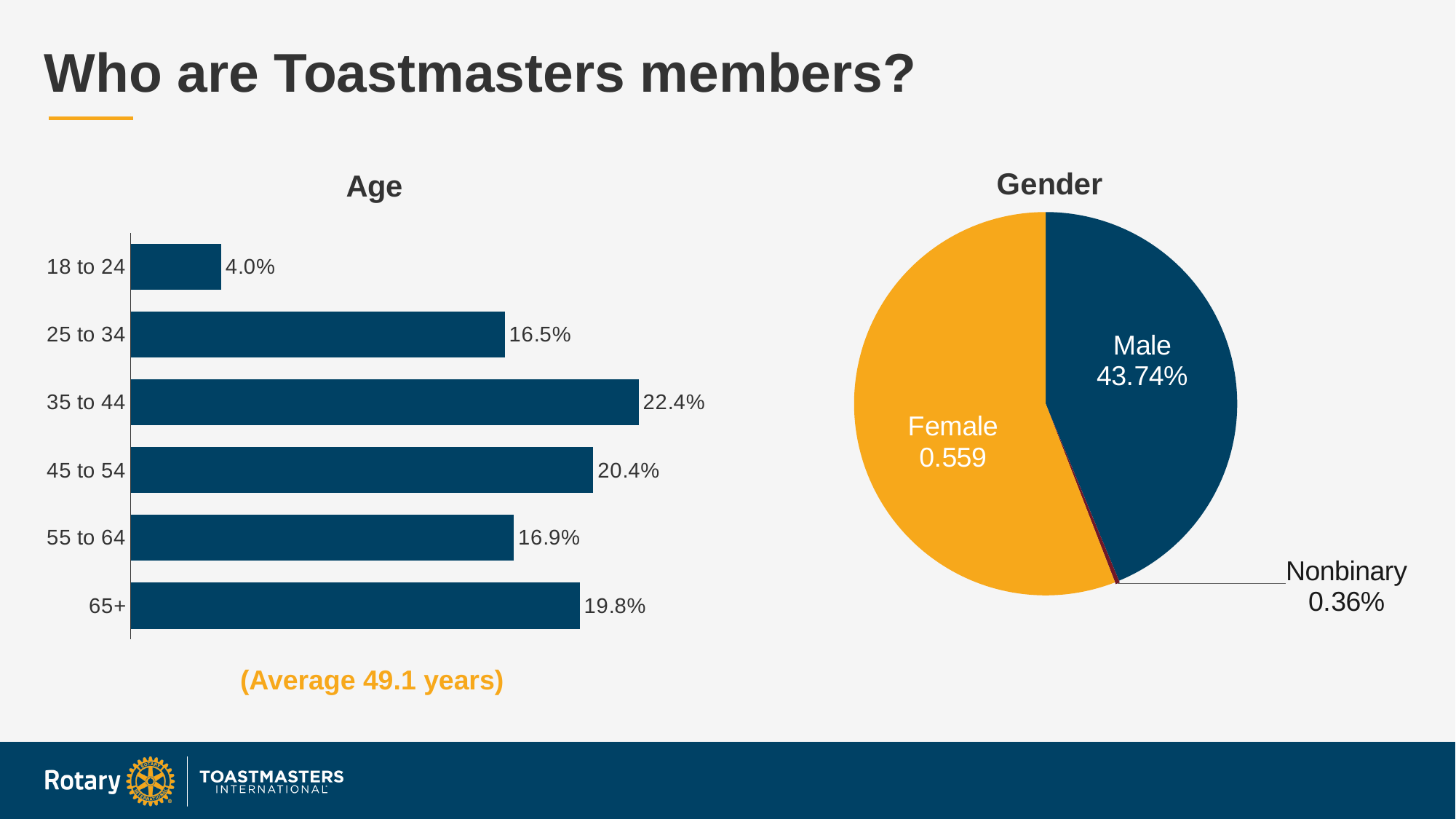
In the Age chart, what is the value for the 18 to 24 age group? 4.0% How many age groups are shown in the Age chart? 6 What kind of chart is the Age chart? bar chart In the Gender chart, what is the value shown for Male? 43.74% In the Age chart, which is larger, the value for 65+ or the value for 55 to 64? 65+ In the Age chart, what is the value for the 35 to 44 age group? 22.4% In the Age chart, what is the difference between the values for 35 to 44 and 45 to 54? 2.0% In the Gender chart, what is the value shown for Nonbinary? 0.36% What average age is stated below the Age chart? 49.1 years In the Gender chart, which category has the largest slice? Female In the Age chart, which age group has the lowest value? 18 to 24 In the Age chart, which age group has the highest value? 35 to 44